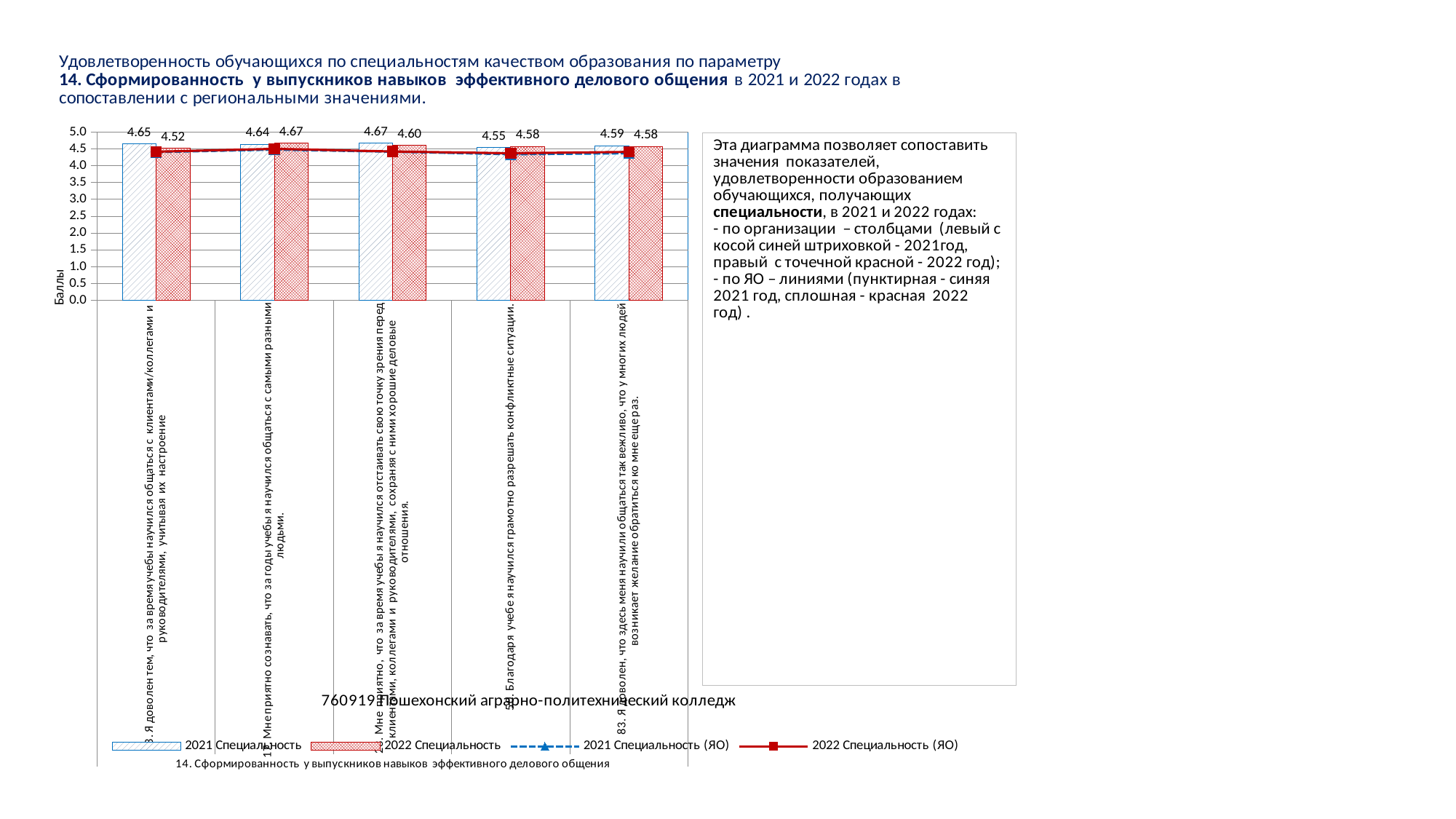
For the category about defending one's point of view ("Мне приятно, что за время учебы я научился отстаивать свою точку зрения..."), which bar is larger: 2021 Специальность or 2022 Специальность? 2021 Специальность How many series does the chart legend list? 4 Which category has the highest 2022 Специальность bar? Мне приятно сознавать, что за годы учебы я научился общаться с самыми разными людьми (4.67) How many categories are shown on the x axis of the chart? 5 Which category has the lowest 2022 Специальность bar? 3. Я доволен тем, что за время учебы научился общаться с клиентами/коллегами и руководителями... (4.52) Which category has the lowest 2021 Специальность bar? Благодаря учебе я научился грамотно разрешать конфликтные ситуации (4.55) Is the value of the 2022 Специальность (ЯО) line for the first category greater or less than 4.0? greater What is the value of the 2021 Специальность bar for the first category ("3. Я доволен тем, что за время учебы научился общаться с клиентами/коллегами и руководителями...")? 4.65 What is the difference between the 2021 Специальность and 2022 Специальность bars for the first category ("3. Я доволен тем...")? 0.13 What kind of chart is shown on the slide? Bar chart with line series What is the value of the 2022 Специальность bar for the category "Благодаря учебе я научился грамотно разрешать конфликтные ситуации"? 4.58 What is the value of the 2022 Специальность bar for the category "83. Я доволен, что здесь меня научили общаться так вежливо..."? 4.58